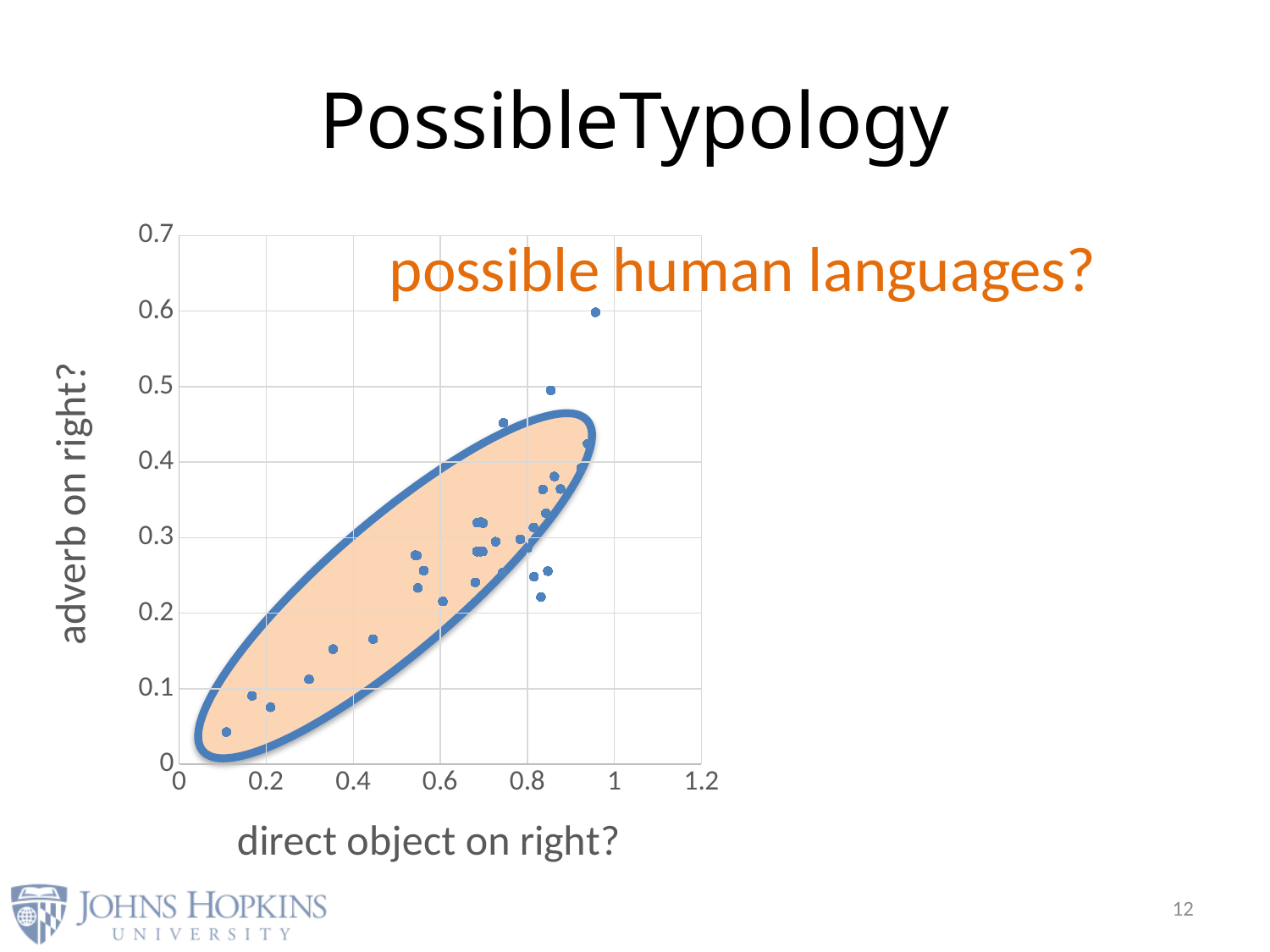
Is the y value of the lowest plotted point greater or less than 0.1? less Is the x value of the leftmost plotted point greater or less than 0.2? less As the value on the x axis (direct object on right?) increases, do the plotted points generally rise or fall? rise Is the y value of the highest plotted point greater or less than 0.7? less What is the label of the x axis of the chart? direct object on right? What text is written in orange over the chart? possible human languages? What kind of chart is shown on the slide? scatter plot